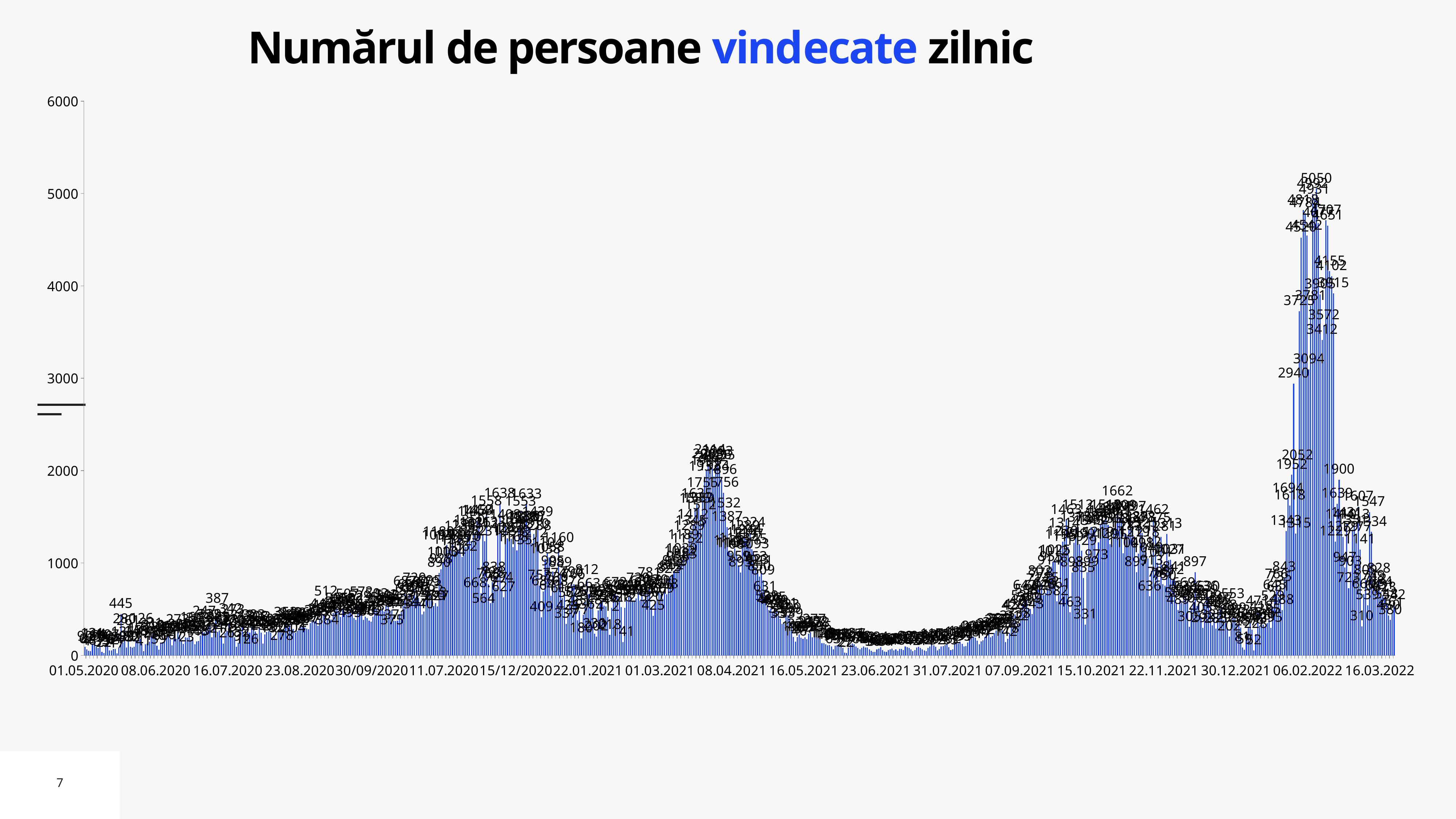
What is the highest value labelled on the chart? 5050 Do the values rise or fall between 23.06.2021 and 15.10.2021? rise Is the value for 16.03.2022 greater or less than 1000? less Do the values rise or fall between 06.02.2022 and 16.03.2022? fall What is the first date shown on the horizontal axis? 01.05.2020 What kind of chart is shown on the slide? bar chart What is the title of the chart? Numărul de persoane vindecate zilnic Is the value for 01.05.2020 greater or less than 1000? less What is the maximum value shown on the vertical axis? 6000 Is the highest value on the chart greater or less than 5000? greater